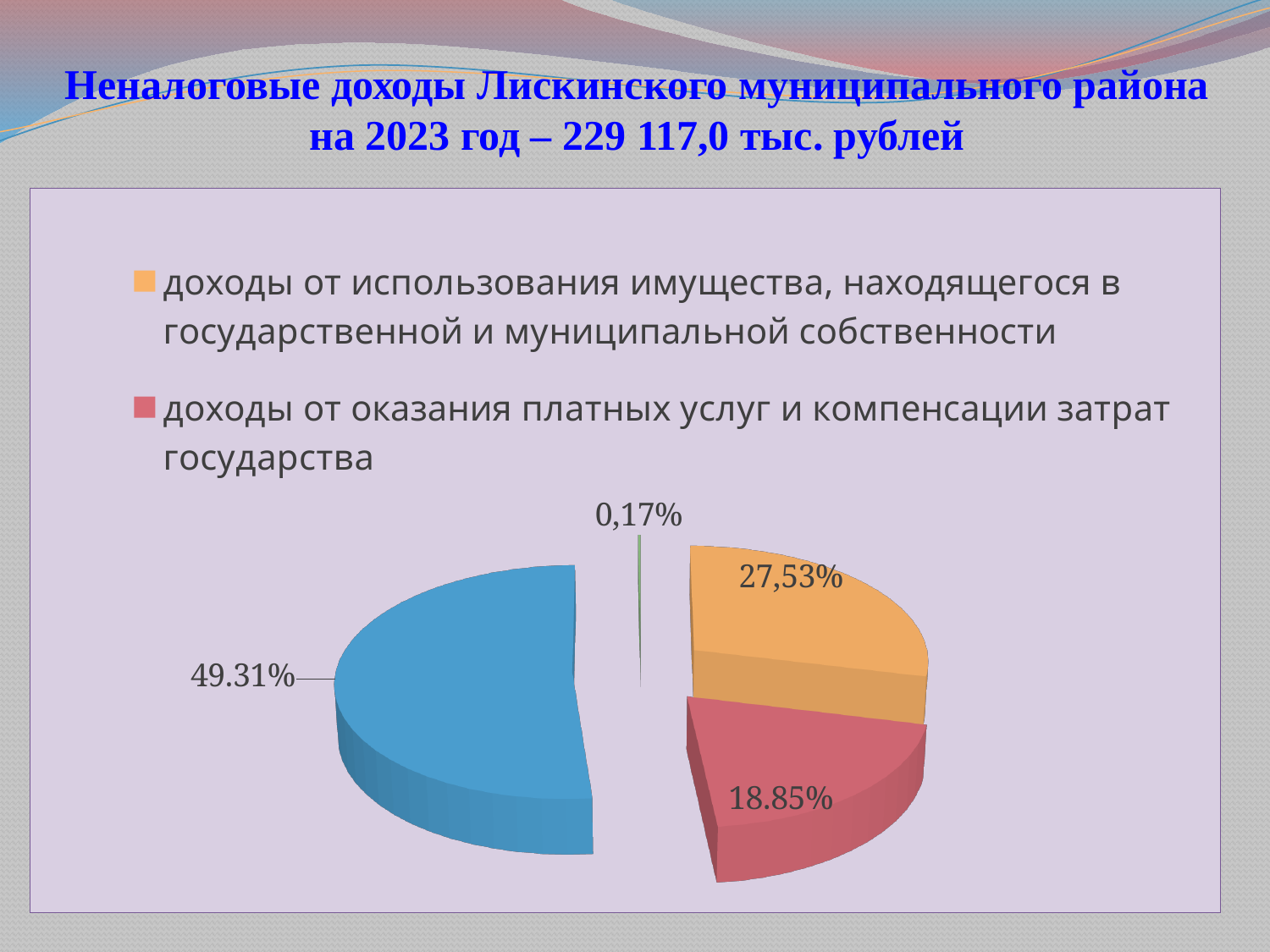
What value is printed on the blue slice of the pie? 49.31% What share of the pie is labelled for 'доходы от оказания платных услуг и компенсации затрат государства'? 18.85% According to the slide title, what is the total of non-tax revenues of the Liskinsky municipal district for 2023? 229 117,0 тыс. рублей What value is printed for the smallest slice of the pie? 0,17% How many entries does the legend list? 2 What kind of chart is shown on the slide? pie chart What colour is the slice for 'доходы от оказания платных услуг и компенсации затрат государства'? red How many slices does the pie chart have? 4 What value is printed for the largest slice of the pie? 49.31% What share of the pie is labelled for 'доходы от использования имущества, находящегося в государственной и муниципальной собственности'? 27,53% Which is larger: the share for 'доходы от использования имущества' or the share for 'доходы от оказания платных услуг'? доходы от использования имущества